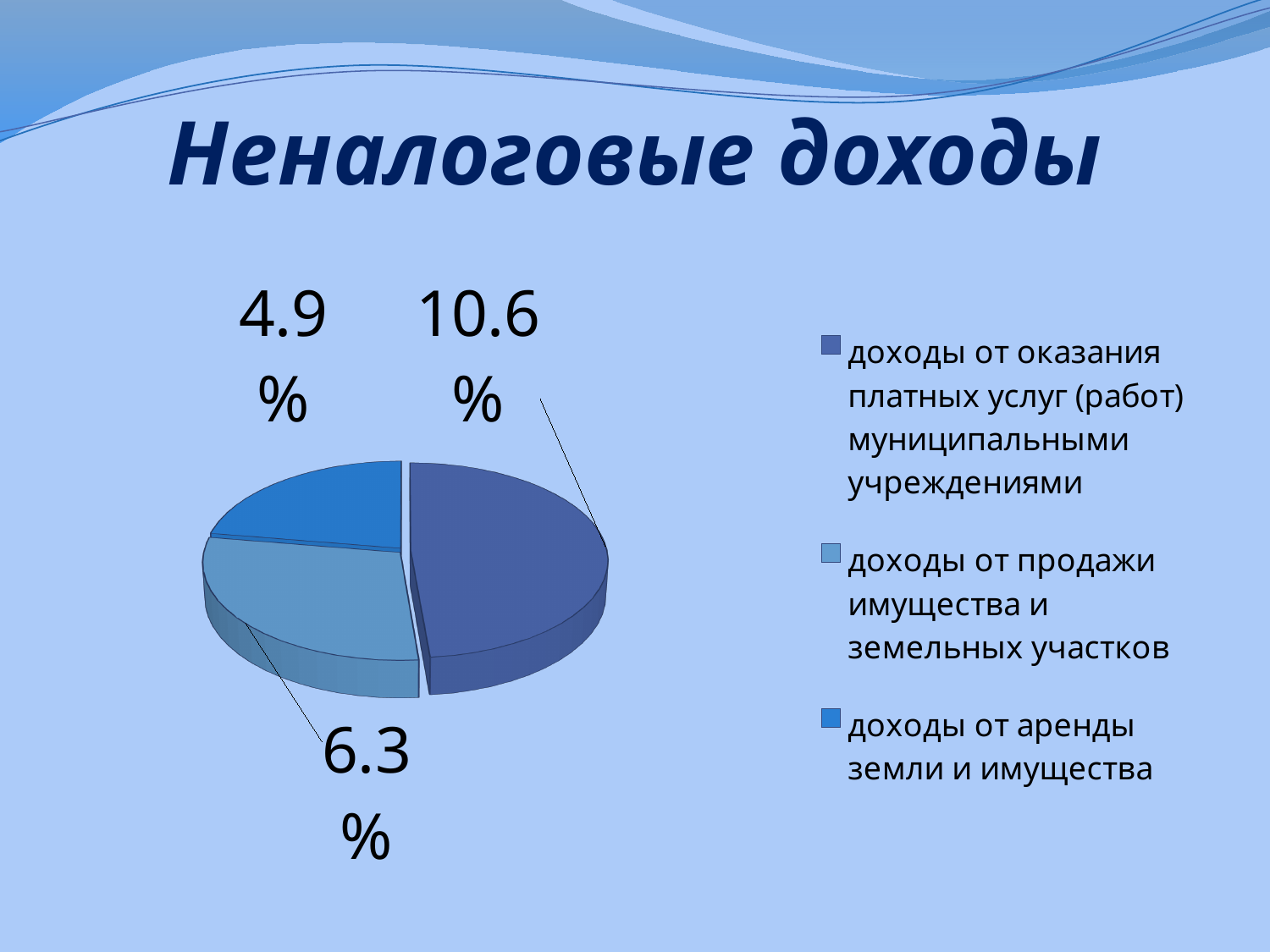
What percentage is shown for доходы от аренды земли и имущества? 4.9% What is the difference between the value for доходы от оказания платных услуг and the value for доходы от продажи имущества и земельных участков? 4.3% How many slices does the pie chart have? 3 What is the title of the chart on the slide? Неналоговые доходы What is the difference between the value for доходы от продажи имущества и земельных участков and the value for доходы от аренды земли и имущества? 1.4% What kind of chart is shown on the slide? pie chart Which is larger: доходы от продажи имущества и земельных участков or доходы от аренды земли и имущества? доходы от продажи имущества и земельных участков How many entries does the legend list? 3 What percentage is shown for доходы от оказания платных услуг (работ) муниципальными учреждениями? 10.6% What percentage is shown for доходы от продажи имущества и земельных участков? 6.3% Which category has the smallest slice of the pie? доходы от аренды земли и имущества Which category has the largest slice of the pie? доходы от оказания платных услуг (работ) муниципальными учреждениями